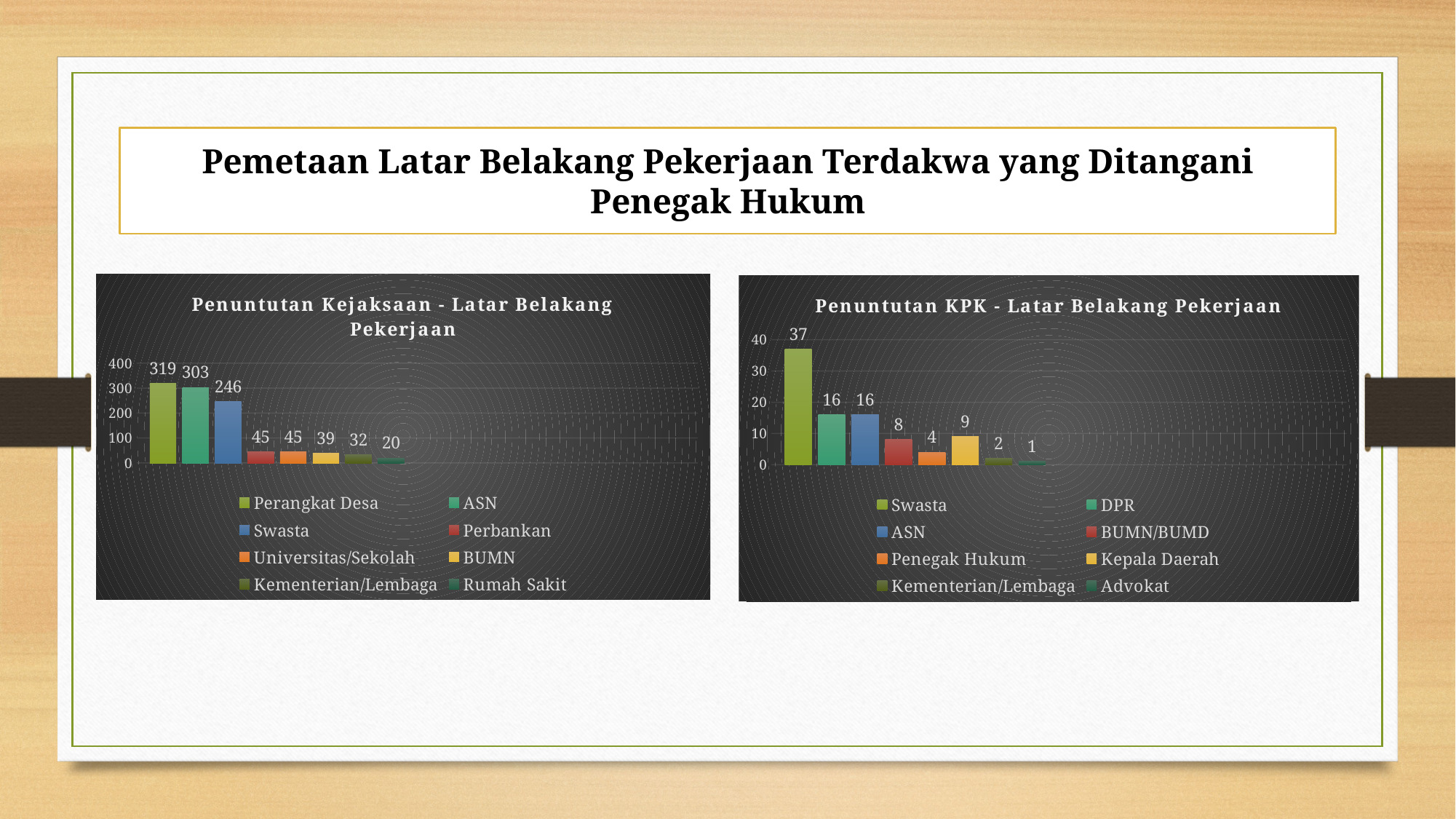
In the 'Penuntutan KPK - Latar Belakang Pekerjaan' chart, which category has the highest value? Swasta In the 'Penuntutan Kejaksaan - Latar Belakang Pekerjaan' chart, what is the value for Perangkat Desa? 319 In the 'Penuntutan Kejaksaan - Latar Belakang Pekerjaan' chart, which category has the lowest value? Rumah Sakit In the 'Penuntutan Kejaksaan - Latar Belakang Pekerjaan' chart, what is the difference between Perangkat Desa and ASN? 16 In the 'Penuntutan Kejaksaan - Latar Belakang Pekerjaan' chart, how many categories are plotted? 8 In the 'Penuntutan KPK - Latar Belakang Pekerjaan' chart, what is the value for Swasta? 37 What type of chart is the 'Penuntutan KPK - Latar Belakang Pekerjaan' chart? Bar chart In the 'Penuntutan KPK - Latar Belakang Pekerjaan' chart, what is the value for Kepala Daerah? 9 In the 'Penuntutan Kejaksaan - Latar Belakang Pekerjaan' chart, what is the value for Swasta? 246 In the 'Penuntutan Kejaksaan - Latar Belakang Pekerjaan' chart, what colour is the bar for Swasta? Blue In the 'Penuntutan KPK - Latar Belakang Pekerjaan' chart, what is the difference between Swasta and DPR? 21 In the 'Penuntutan KPK - Latar Belakang Pekerjaan' chart, which is larger, BUMN/BUMD or Penegak Hukum? BUMN/BUMD